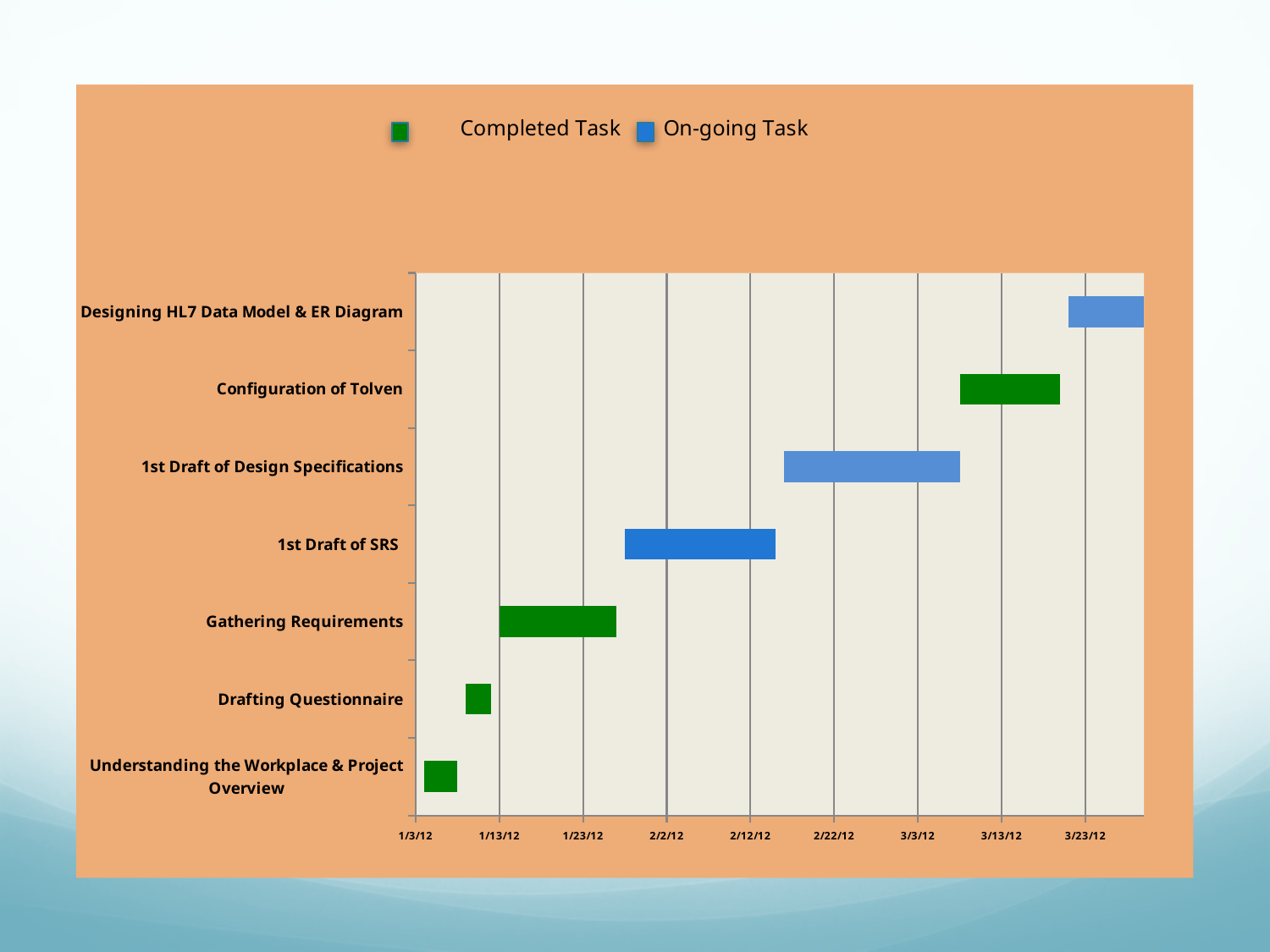
Which colour represents an On-going Task in the legend? Blue Which colour represents a Completed Task in the legend? Green Which task has a longer bar: Gathering Requirements or Drafting Questionnaire? Gathering Requirements Which task has the longest bar (longest duration) in the chart? 1st Draft of Design Specifications How many tasks are shown as Completed (green bars)? 4 How many tasks are listed on the vertical axis of the chart? 7 Does the 1st Draft of SRS task start before or after 2/2/12? before What kind of chart is shown on the slide? Bar chart (Gantt chart) How many entries does the legend list? 2 Which task has the shortest bar (shortest duration) in the chart? Drafting Questionnaire Which task starts earliest on the timeline? Understanding the Workplace & Project Overview Which task starts latest on the timeline? Designing HL7 Data Model & ER Diagram